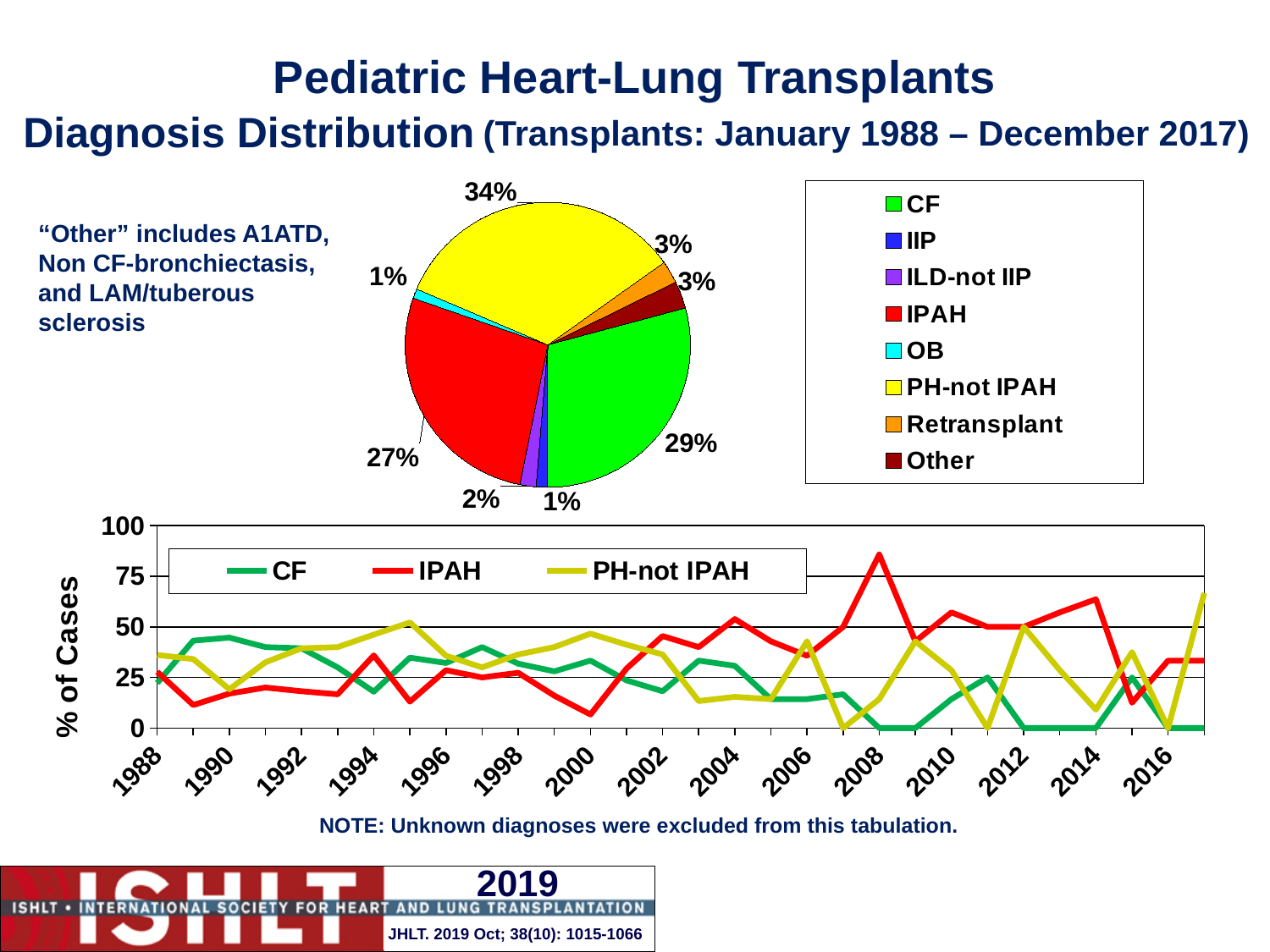
In the pie chart, which has the larger share, CF or IPAH? CF In the pie chart, what share of cases is CF? 29% In the bottom line chart, is the value for CF in 2008 greater or less than 25? less In the pie chart, which diagnosis has the largest share? PH-not IPAH In the pie chart, what is the difference in percentage points between the PH-not IPAH share and the CF share? 5% In the bottom line chart, is the value for IPAH in 2008 greater or less than 75? greater In the pie chart, what share of cases is PH-not IPAH? 34% In the bottom chart showing % of cases by year, how many series does the legend list? 3 In the pie chart, how many diagnosis categories does the legend list? 8 What kind of chart is the bottom chart showing % of cases by year? line chart In the pie chart, what share of cases is Retransplant? 3%